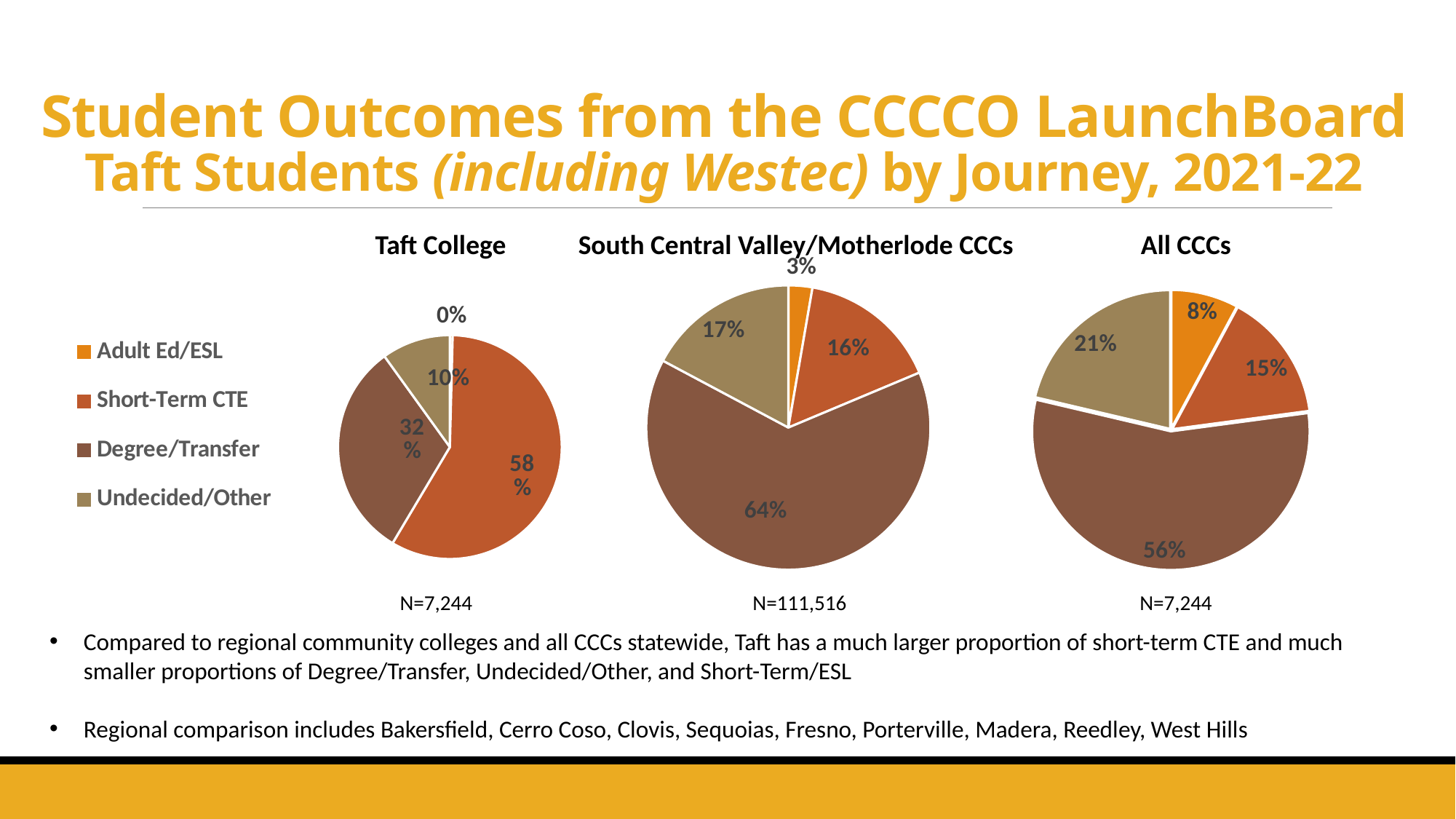
In the Taft College pie chart, what percentage is Degree/Transfer? 32% Which is larger: the Short-Term CTE share in the Taft College chart or the Short-Term CTE share in the All CCCs chart? Taft College What type of chart is used on this slide? Pie chart In the Taft College pie chart, which category has the largest share? Short-Term CTE In the South Central Valley/Motherlode CCCs pie chart, which category has the smallest share? Adult Ed/ESL What is the N value shown under the South Central Valley/Motherlode CCCs pie chart? N=111,516 In the Taft College pie chart, what percentage is Short-Term CTE? 58% In the South Central Valley/Motherlode CCCs pie chart, what percentage is Degree/Transfer? 64% In the All CCCs pie chart, what percentage is Undecided/Other? 21% What is the difference between the Degree/Transfer share in the South Central Valley/Motherlode CCCs chart and the Degree/Transfer share in the Taft College chart? 32 percentage points How many categories does the legend list? 4 In the All CCCs pie chart, what percentage is Adult Ed/ESL? 8%